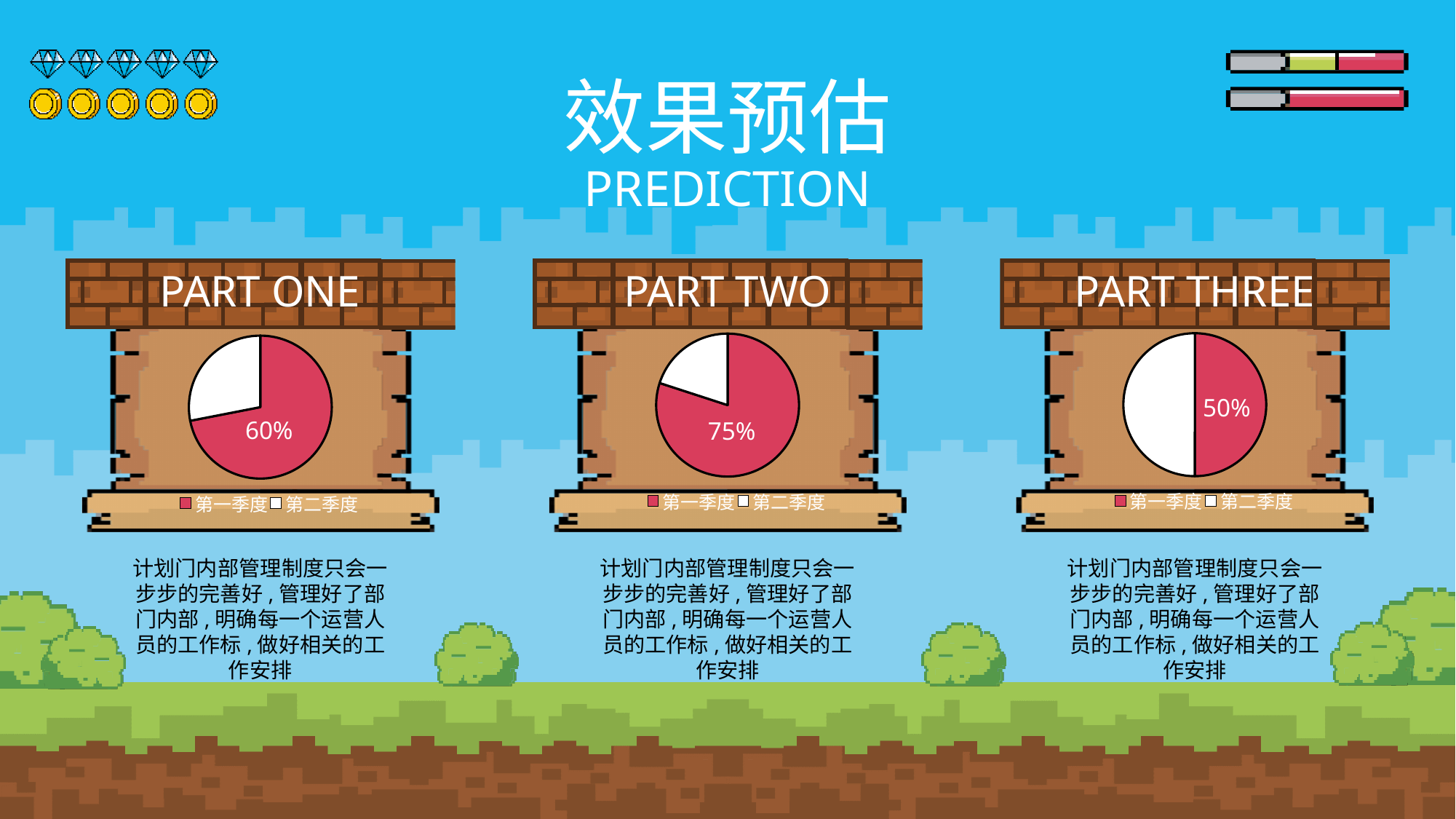
In the PART ONE pie chart, which slice is larger, 第一季度 or 第二季度? 第一季度 In the PART THREE pie chart, what percentage is shown for 第一季度? 50% How many entries does the legend of the PART TWO chart list? 2 In the PART ONE pie chart, what colour is the 第一季度 slice? Red Which of the three pie charts shows the highest value for 第一季度? PART TWO What kind of chart is shown under PART ONE? Pie chart In the PART ONE pie chart, what percentage is shown for 第一季度? 60% In the PART TWO pie chart, what percentage is shown for 第一季度? 75% In the PART TWO pie chart, which slice is larger, 第一季度 or 第二季度? 第一季度 What are the two legend entries shown under the PART THREE chart? 第一季度 and 第二季度 How many slices does the PART THREE pie chart have? 2 Which of the three pie charts shows the lowest value for 第一季度? PART THREE